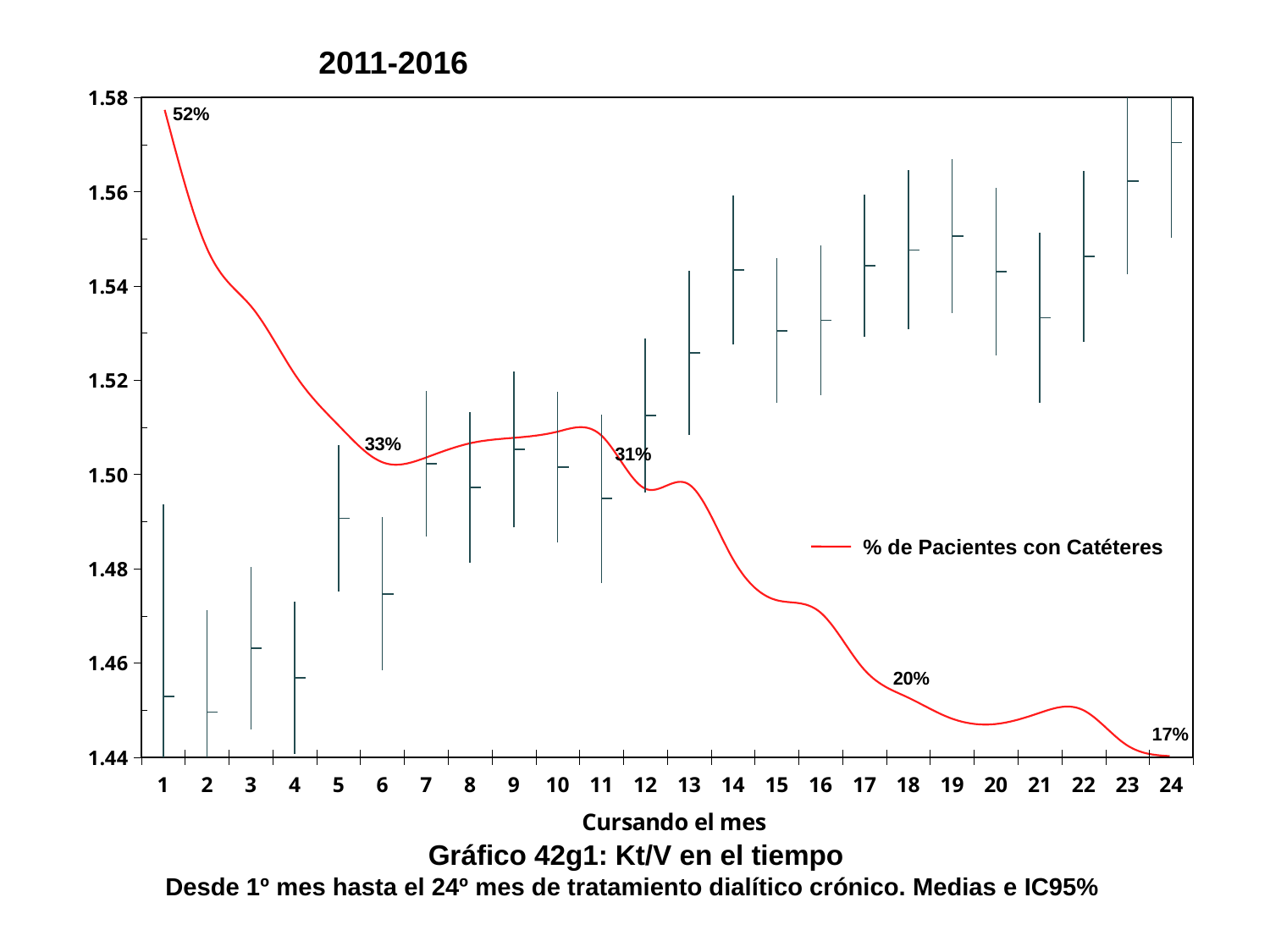
Is the mean Kt/V value at month 1 greater or less than 1.46? less Does the percentage of patients with catheters rise or fall from month 1 to month 24? fall Which of the labelled catheter percentages is the lowest? 17% What is the label of the x axis? Cursando el mes Does the mean Kt/V generally rise or fall from month 1 to month 24? rise What percentage label appears on the catheter line near month 18? 20% What is the difference between the catheter percentage labelled at month 1 and the one labelled at month 24? 35 percentage points What percentage of patients with catheters is labelled at month 24? 17% Which of the labelled catheter percentages is the highest? 52% How many months are shown on the x axis? 24 Is the mean Kt/V value at month 24 greater or less than 1.56? greater What percentage of patients with catheters is labelled at month 1? 52%